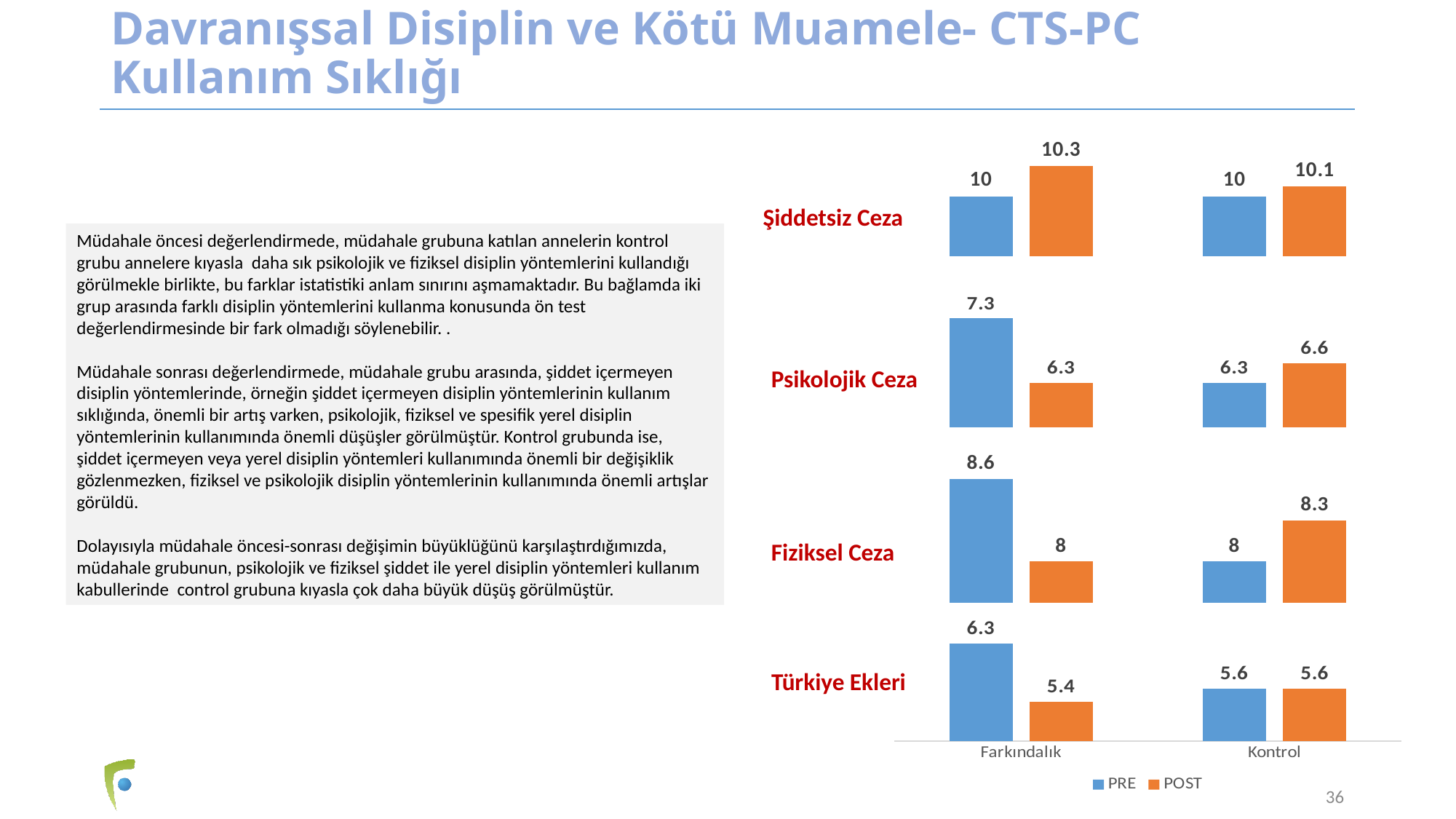
In the Şiddetsiz Ceza chart, which is larger for Kontrol, the PRE value or the POST value? POST In the Şiddetsiz Ceza chart, what is the POST value for Farkındalık? 10.3 In the Fiziksel Ceza chart, which bar has the highest value? Farkındalık PRE What kind of chart is used on the slide? Bar chart In the Türkiye Ekleri chart, what is the POST value for Farkındalık? 5.4 How many series does the legend list? 2 In the Türkiye Ekleri chart, which is larger for Farkındalık, the PRE value or the POST value? PRE In the Türkiye Ekleri chart, which bar has the lowest value? Farkındalık POST In the Fiziksel Ceza chart, what is the POST value for Kontrol? 8.3 In the Fiziksel Ceza chart, what is the difference between the PRE and POST values for Farkındalık? 0.6 In the Psikolojik Ceza chart, what is the PRE value for Farkındalık? 7.3 In the Psikolojik Ceza chart, what is the difference between the PRE and POST values for Farkındalık? 1